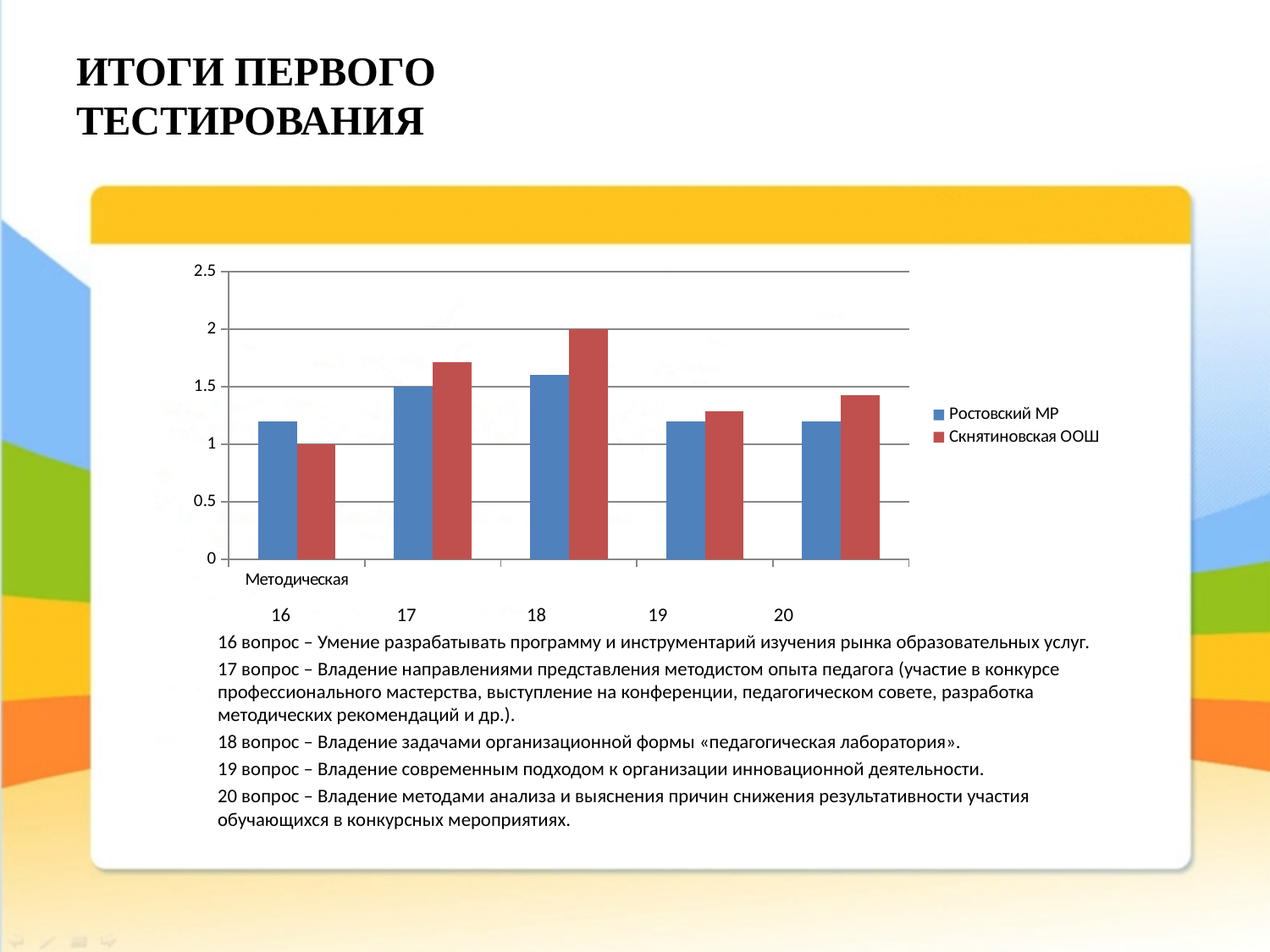
For which question is the Скнятиновская ООШ value lowest? 16 What is the value for Скнятиновская ООШ for question 18? 2 Which series is shown in blue in the legend? Ростовский МР Is the value for Скнятиновская ООШ for question 17 greater or less than 1.5? greater What is the value for Скнятиновская ООШ for question 16? 1 How many question categories are plotted along the x axis? 5 How many series does the legend list? 2 What kind of chart is shown on the slide? bar chart What is the value for Ростовский МР for question 17? 1.5 For question 16, which series has the larger value, Ростовский МР or Скнятиновская ООШ? Ростовский МР For which question is the Скнятиновская ООШ value highest? 18 For question 20, which series has the larger value, Ростовский МР or Скнятиновская ООШ? Скнятиновская ООШ